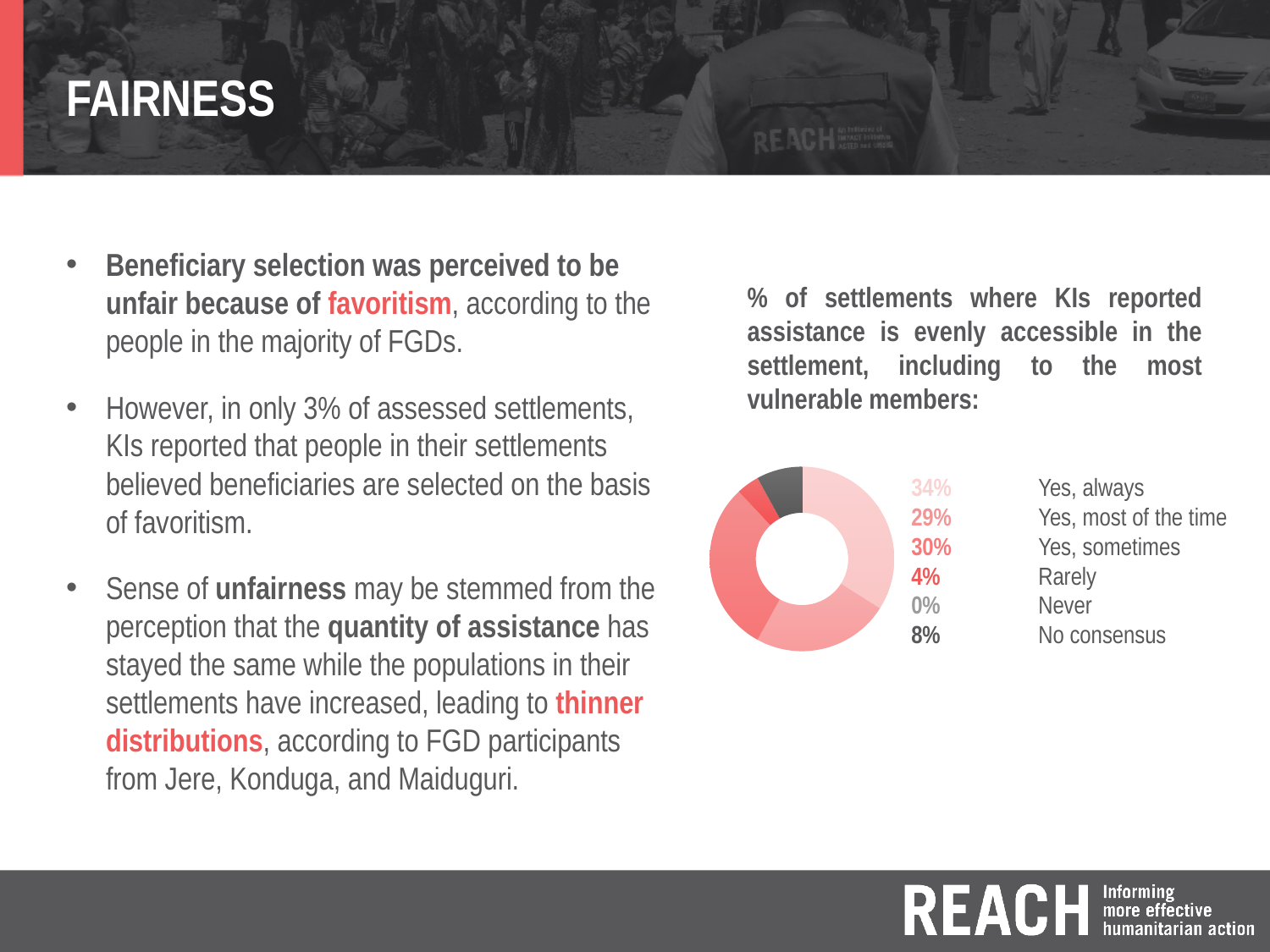
What is the combined percentage of the three 'Yes' categories? 93% Which is larger: 'Yes, sometimes' or 'Yes, most of the time'? Yes, sometimes What percentage corresponds to 'Rarely'? 4% What kind of chart is shown on the slide? Pie chart (donut) How many categories are shown in the chart's legend? 6 What percentage corresponds to 'Yes, sometimes'? 30% What is the difference in percentage points between 'Yes, always' and 'Yes, most of the time'? 5 percentage points What percentage corresponds to 'Yes, most of the time'? 29% Which category has the smallest share of the chart? Never What percentage of settlements reported assistance is evenly accessible 'Yes, always'? 34% What percentage corresponds to 'No consensus'? 8% Which category has the largest share of the chart? Yes, always